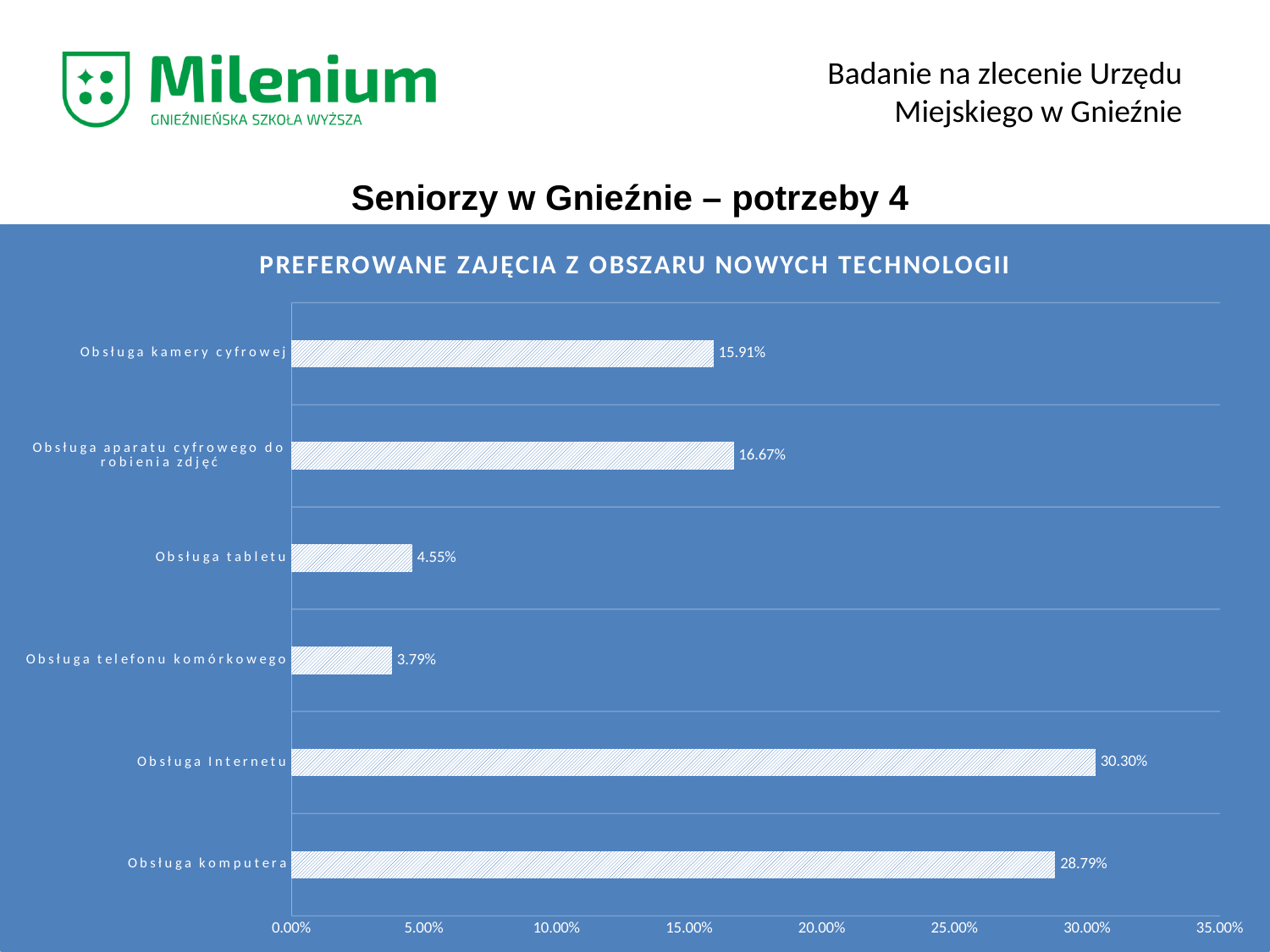
What kind of chart is shown on the slide? Bar chart What is the value for Obsługa tabletu? 4.55% Which category has the lowest value? Obsługa telefonu komórkowego How many categories are shown in the chart? 6 What is the title of the chart? PREFEROWANE ZAJĘCIA Z OBSZARU NOWYCH TECHNOLOGII What is the maximum value shown on the x axis? 35.00% Which is larger, the value for Obsługa kamery cyfrowej or Obsługa aparatu cyfrowego do robienia zdjęć? Obsługa aparatu cyfrowego do robienia zdjęć What is the difference between the values for Obsługa Internetu and Obsługa komputera? 1.51% What is the value for Obsługa aparatu cyfrowego do robienia zdjęć? 16.67% What is the value for Obsługa Internetu? 30.30% Which category has the highest value? Obsługa Internetu Is the value for Obsługa komputera greater or less than 25.00%? greater